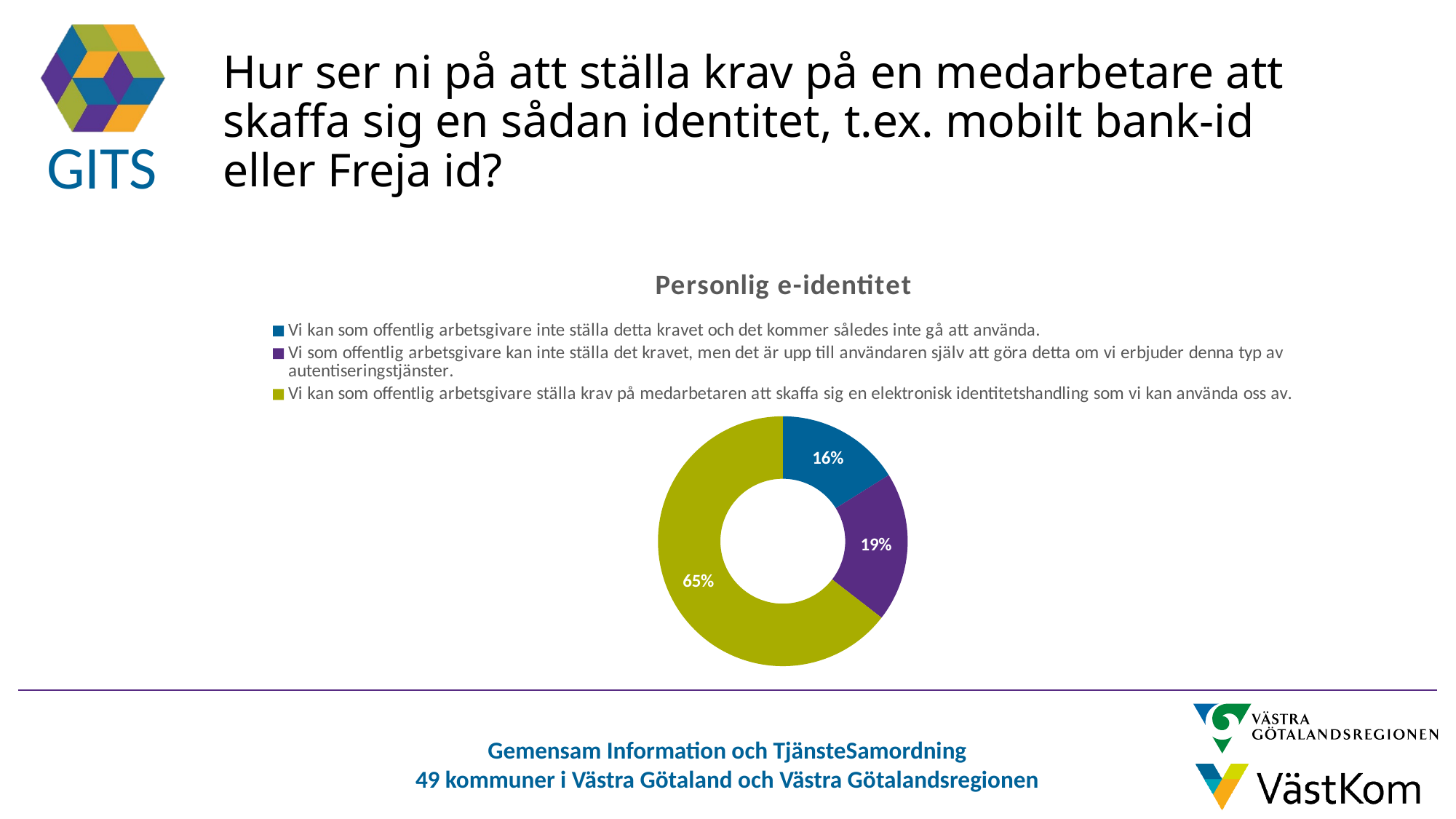
Which response has the smallest share of the doughnut chart? Vi kan som offentlig arbetsgivare inte ställa detta kravet och det kommer således inte gå att använda. What colour is the slice labelled 65%? Olive green Which is larger: the 19% slice or the 16% slice? The 19% slice Which response has the largest share of the doughnut chart? Vi kan som offentlig arbetsgivare ställa krav på medarbetaren att skaffa sig en elektronisk identitetshandling som vi kan använda oss av. What percentage is shown for the slice 'Vi kan som offentlig arbetsgivare inte ställa detta kravet och det kommer således inte gå att använda.'? 16% What is the title of the chart? Personlig e-identitet What percentage is shown for the slice 'Vi som offentlig arbetsgivare kan inte ställa det kravet, men det är upp till användaren själv att göra detta om vi erbjuder denna typ av autentiseringstjänster.'? 19% What percentage is shown for the slice 'Vi kan som offentlig arbetsgivare ställa krav på medarbetaren att skaffa sig en elektronisk identitetshandling som vi kan använda oss av.'? 65% How many slices does the doughnut chart have? 3 What kind of chart is shown on the slide? Doughnut chart What is the difference in percentage points between the largest slice (65%) and the smallest slice (16%)? 49 percentage points How many entries does the chart legend list? 3